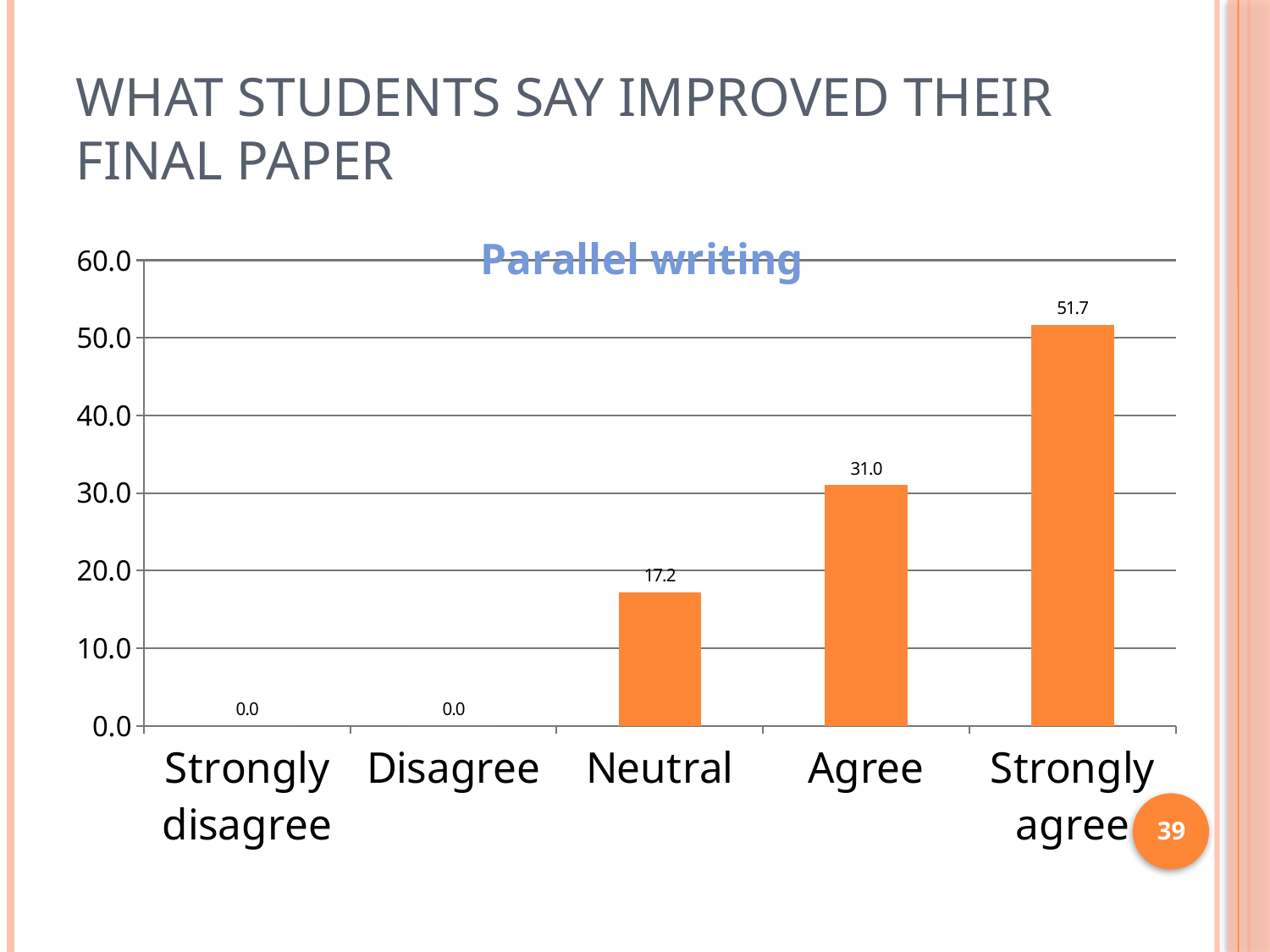
Which category has the highest value? Strongly agree What kind of chart is shown on the slide? Bar chart What is the value for Neutral? 17.2 Which is larger, the value for Agree or the value for Neutral? Agree What is the title of the chart? Parallel writing What is the difference between the values for Strongly agree and Agree? 20.7 How many categories are shown on the x axis? 5 What is the value for Agree? 31.0 Is the value for Strongly agree greater or less than 50.0? greater What is the value for Disagree? 0.0 What is the difference between the values for Agree and Neutral? 13.8 What is the value for Strongly agree? 51.7